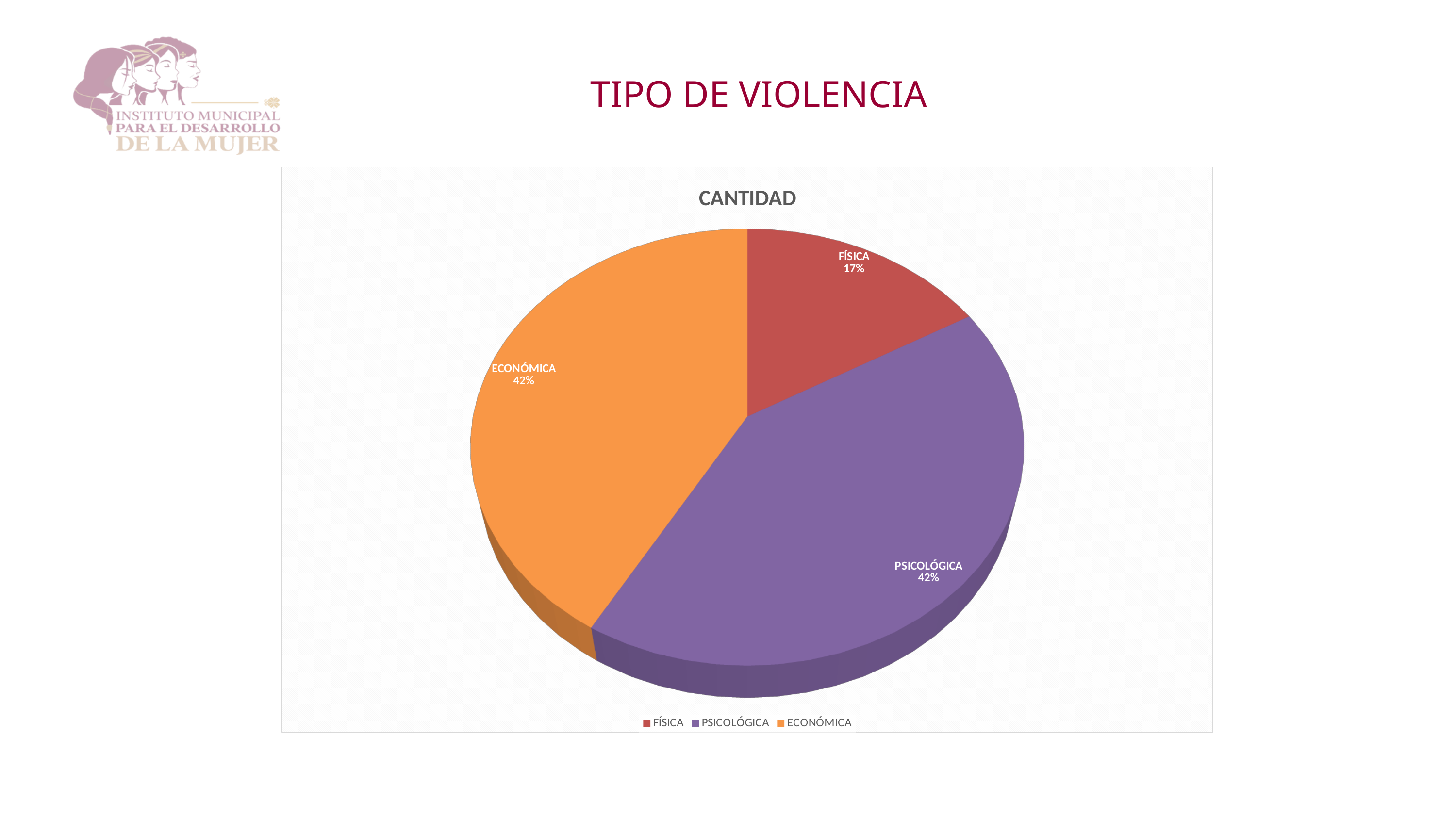
How many entries are listed in the legend? 3 Which is larger, the share for FÍSICA or the share for PSICOLÓGICA? PSICOLÓGICA Which type of violence has the smallest share of the pie? FÍSICA What percentage does the PSICOLÓGICA slice represent? 42% What percentage does the FÍSICA slice represent? 17% How many slices does the pie chart have? 3 What kind of chart is shown on the slide? Pie chart What share of the pie does ECONÓMICA account for? 42% What is the difference in percentage points between the ECONÓMICA and FÍSICA slices? 25 What is the title of the chart? CANTIDAD What colour is the PSICOLÓGICA slice? Purple What percentage does the ECONÓMICA slice represent? 42%